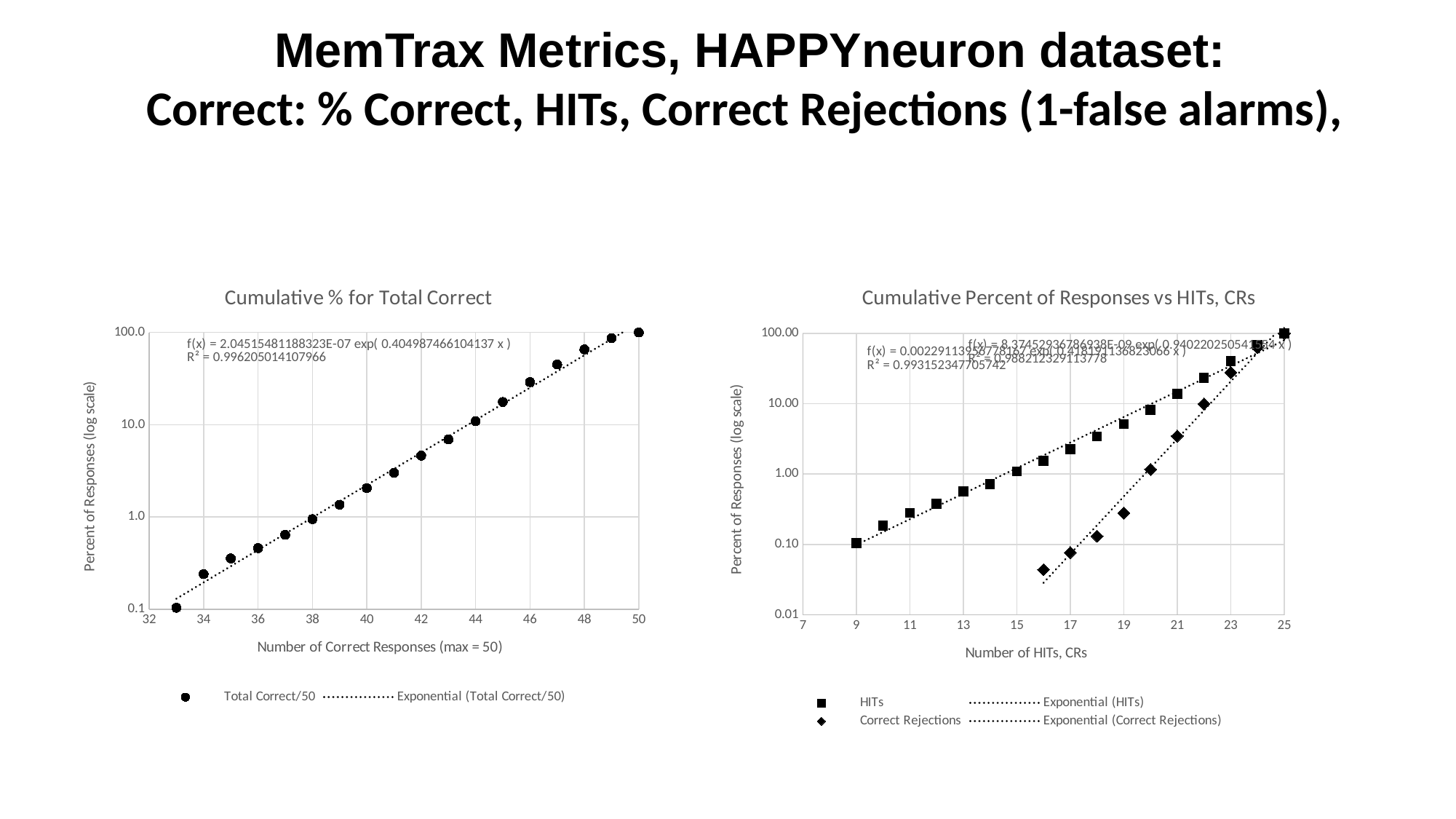
In the right chart "Cumulative Percent of Responses vs HITs, CRs", how many Correct Rejections data points are plotted? 10 In the left chart "Cumulative % for Total Correct", is the value at 46 correct responses greater or less than 10.0? greater In the left chart "Cumulative % for Total Correct", what is the x-axis label? Number of Correct Responses (max = 50) In the right chart "Cumulative Percent of Responses vs HITs, CRs", is the Correct Rejections value at 19 greater or less than 1.00? less In the right chart "Cumulative Percent of Responses vs HITs, CRs", do the Correct Rejections values rise or fall as the number of CRs increases? rise In the left chart "Cumulative % for Total Correct", do the plotted values rise or fall as the number of correct responses increases? rise In the left chart "Cumulative % for Total Correct", is the value at 40 correct responses greater or less than 1.0? greater What kind of chart is the left chart titled "Cumulative % for Total Correct"? scatter chart In the right chart "Cumulative Percent of Responses vs HITs, CRs", which series has the larger value at 19: HITs or Correct Rejections? HITs In the right chart "Cumulative Percent of Responses vs HITs, CRs", what is the y-axis label? Percent of Responses (log scale) In the right chart "Cumulative Percent of Responses vs HITs, CRs", how many entries does the legend list? 4